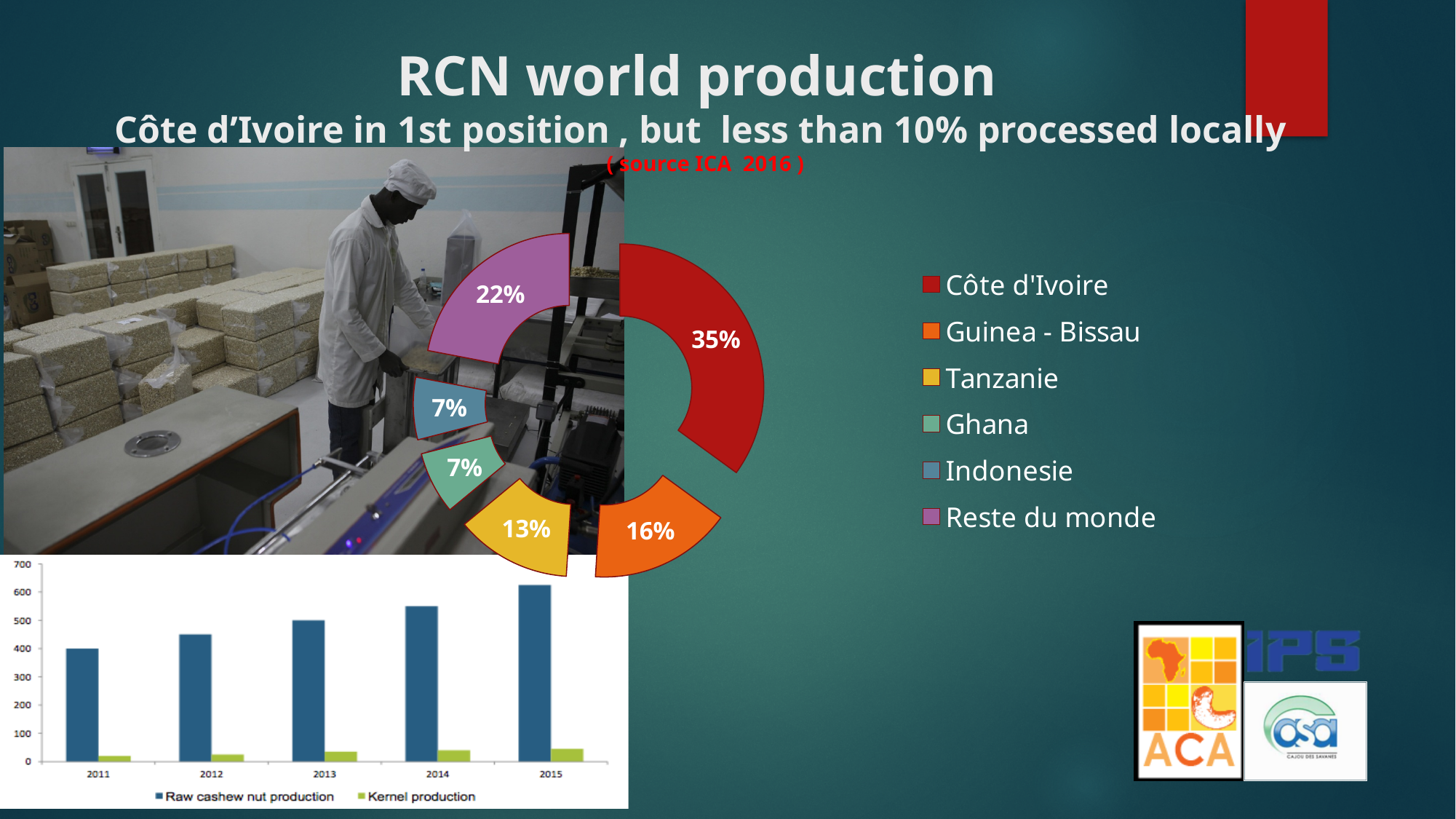
In the bottom-left bar chart, does Raw cashew nut production rise or fall from 2011 to 2015? Rise In the doughnut chart, what is the difference in percentage points between Côte d'Ivoire and Guinea - Bissau? 19 In the doughnut chart, what share is shown for Indonesie? 7% In the doughnut chart, which category has the largest share? Côte d'Ivoire In the doughnut chart, what share is shown for Reste du monde? 22% What kind of chart is the chart at the bottom left of the slide? Bar chart In the bottom-left bar chart, how many series does the legend list? 2 In the bottom-left bar chart, is the Raw cashew nut production value for 2015 greater or less than 600? greater In the doughnut chart, what share of RCN world production does Côte d'Ivoire hold? 35% In the doughnut chart, which is larger, the share for Tanzanie or the share for Ghana? Tanzanie How many categories does the legend of the doughnut chart list? 6 In the doughnut chart, what share is shown for Guinea - Bissau? 16%